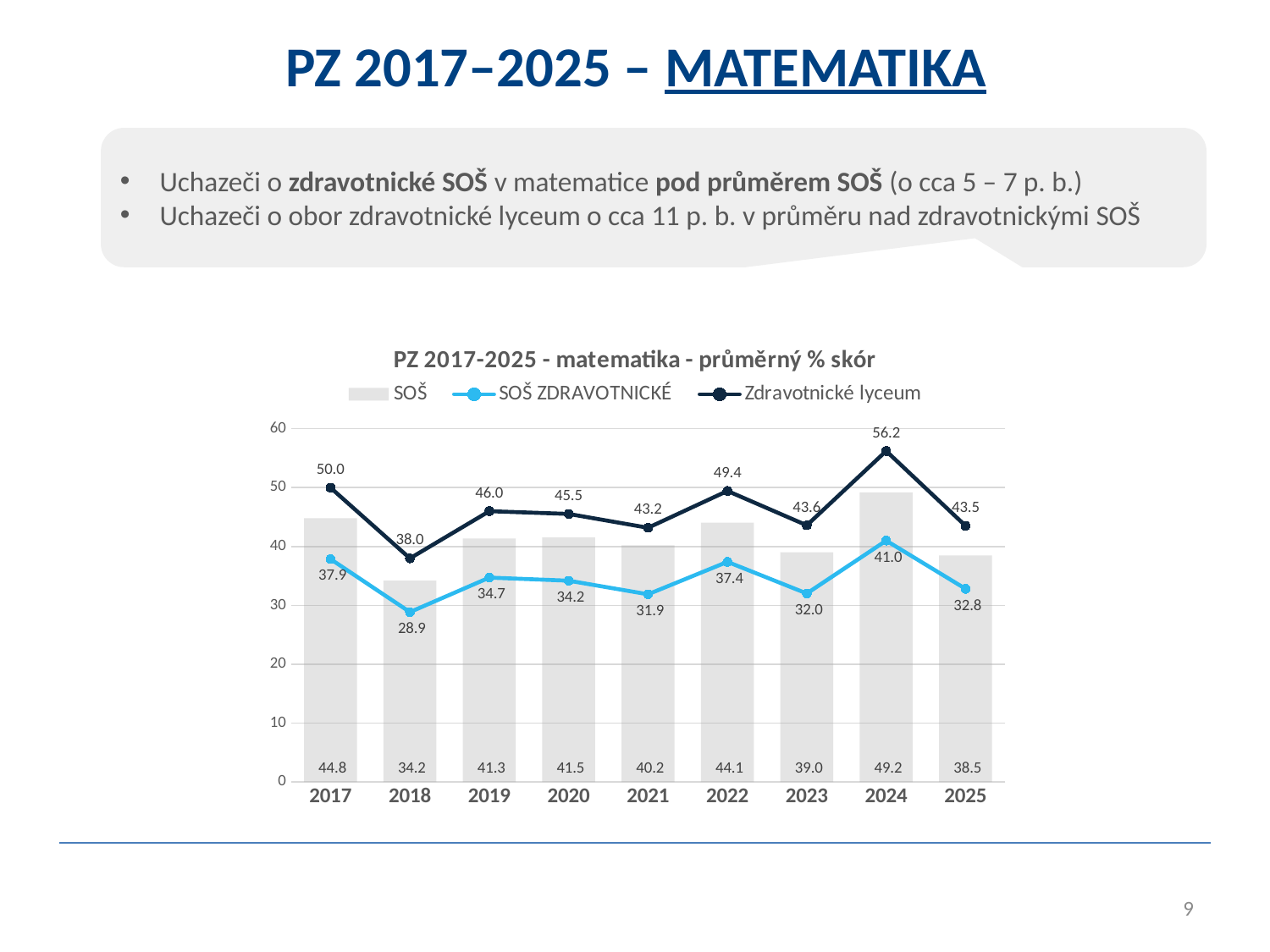
In which year is the SOŠ ZDRAVOTNICKÉ series lowest? 2018 Which is larger in 2017: the SOŠ value or the SOŠ ZDRAVOTNICKÉ value? SOŠ What is the value for Zdravotnické lyceum in 2022? 49.4 Is the value for Zdravotnické lyceum in 2024 greater or less than 50? greater How many series does the legend list? 3 What is the value for SOŠ in 2024? 49.2 What is the difference between Zdravotnické lyceum and SOŠ ZDRAVOTNICKÉ in 2024? 15.2 What is the title of the chart? PZ 2017-2025 - matematika - průměrný % skór Which series is drawn as bars rather than a line? SOŠ How many years are shown on the x axis? 9 In which year is the Zdravotnické lyceum series highest? 2024 What is the value for SOŠ ZDRAVOTNICKÉ in 2018? 28.9